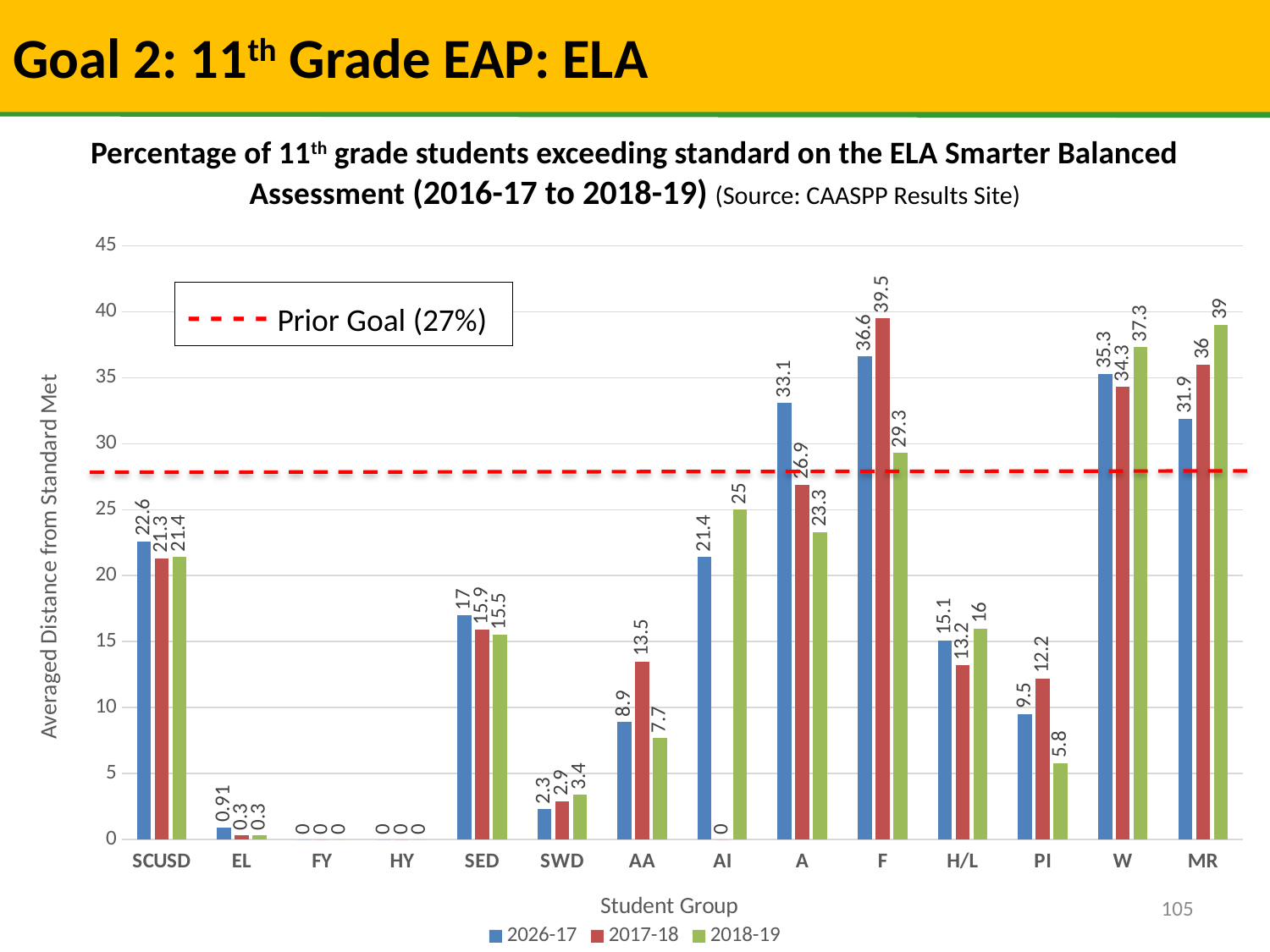
What is the 2017-18 value for the AA student group? 13.5 Which student group has the lowest 2018-19 value among SCUSD, SED, SWD and PI? SWD What is the 2018-19 value for the F student group? 29.3 Is the 2018-19 value for the A student group greater or less than 25? less How many student groups are shown on the x axis? 14 What value does the red dashed line labelled Prior Goal represent? 27% What kind of chart is shown on the slide? bar chart Which student group has the highest 2017-18 value? F What is the difference between the 2018-19 and 2017-18 values for the PI student group? 6.4 Which is larger for the W student group, the 2017-18 value or the 2018-19 value? 2018-19 What is the 2018-19 value for the MR student group? 39 How many series does the legend list? 3